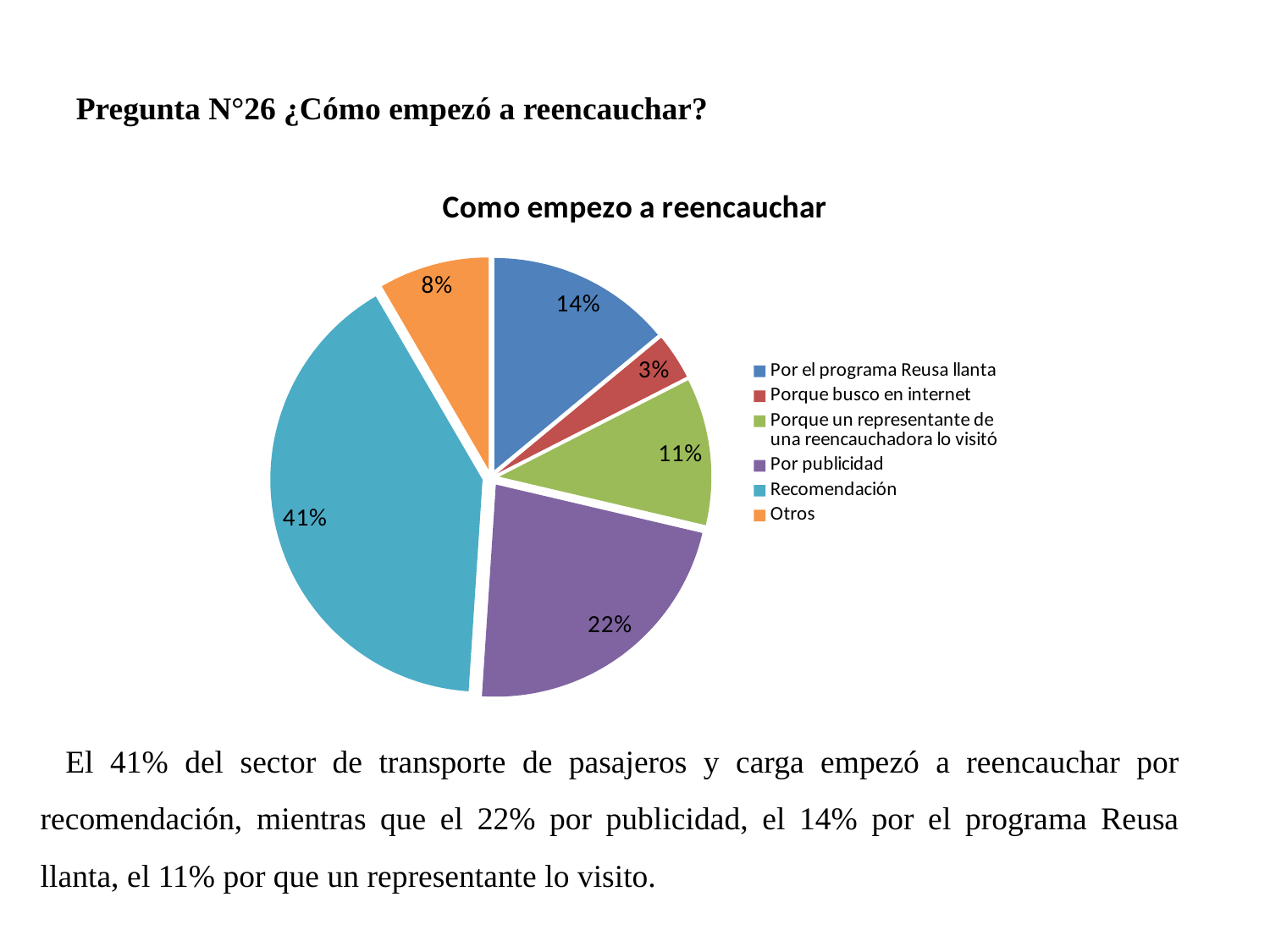
How many categories does the legend list? 6 What is the value for "Porque busco en internet"? 3% What is the difference between the values for "Recomendación" and "Por publicidad"? 19% What is the value for "Por publicidad"? 22% What is the value for "Otros"? 8% Which category has the smallest slice of the pie? Porque busco en internet What is the title of the chart? Como empezo a reencauchar What is the value for "Por el programa Reusa llanta"? 14% Which is larger, the value for "Por el programa Reusa llanta" or the value for "Porque un representante de una reencauchadora lo visitó"? Por el programa Reusa llanta What kind of chart is shown on the slide? Pie chart What share of the pie does "Recomendación" represent? 41% Which category has the largest slice of the pie? Recomendación